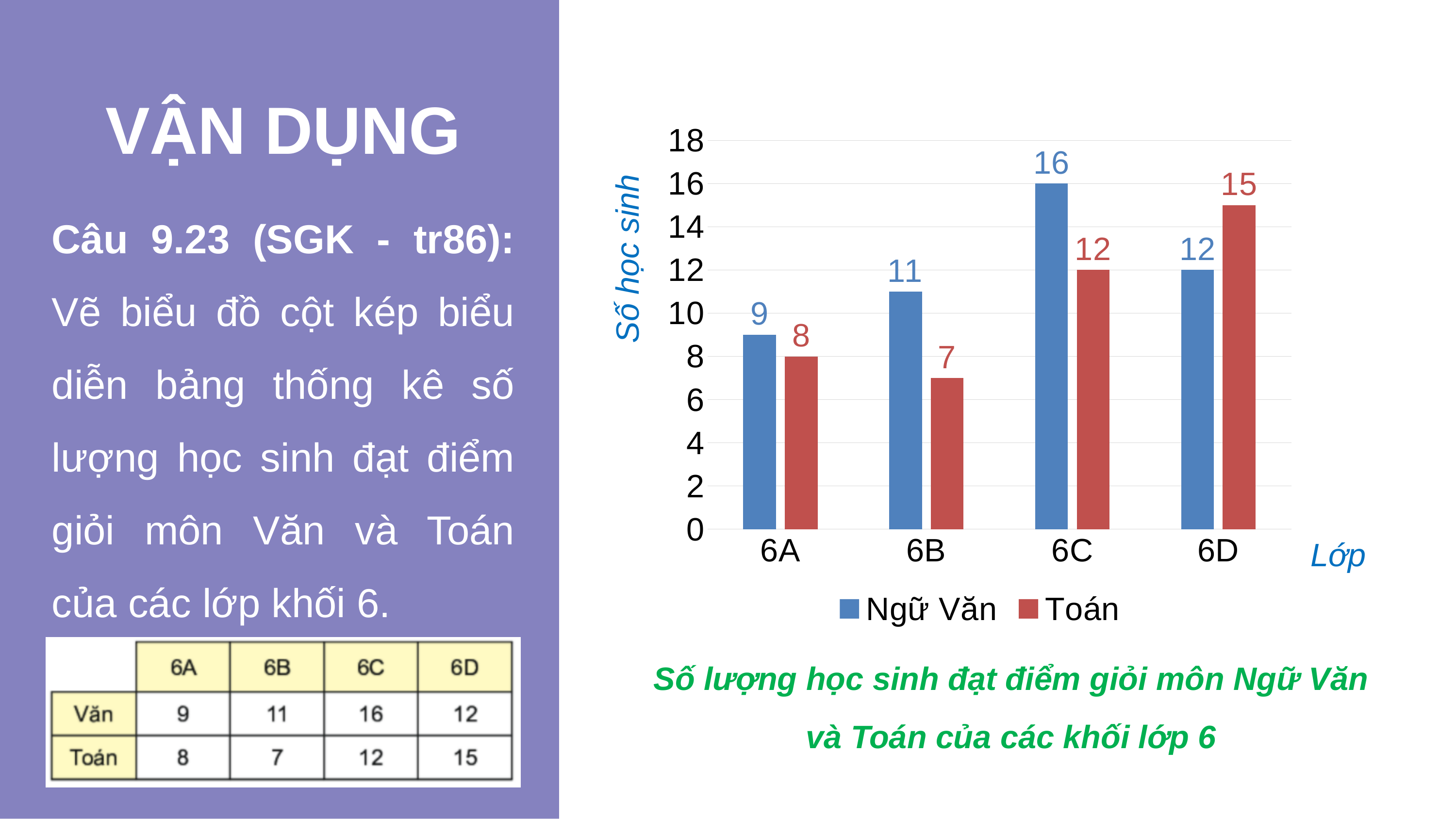
What is the total number of students with excellent marks in Ngữ Văn across all four classes? 48 What colour represents the Toán series in the chart? red Is the Toán value for class 6C greater or less than 10? greater What kind of chart is shown on the slide? bar chart How many classes are shown on the x axis of the chart? 4 How many students in class 6D achieved excellent marks in Toán? 15 How many series does the chart legend list? 2 How many students in class 6A achieved excellent marks in Ngữ Văn? 9 Which class has the highest number of students with excellent marks in Ngữ Văn? 6C What is the difference between the Ngữ Văn and Toán values for class 6B? 4 For class 6D, which subject has more students with excellent marks, Ngữ Văn or Toán? Toán Which class has the lowest number of students with excellent marks in Toán? 6B